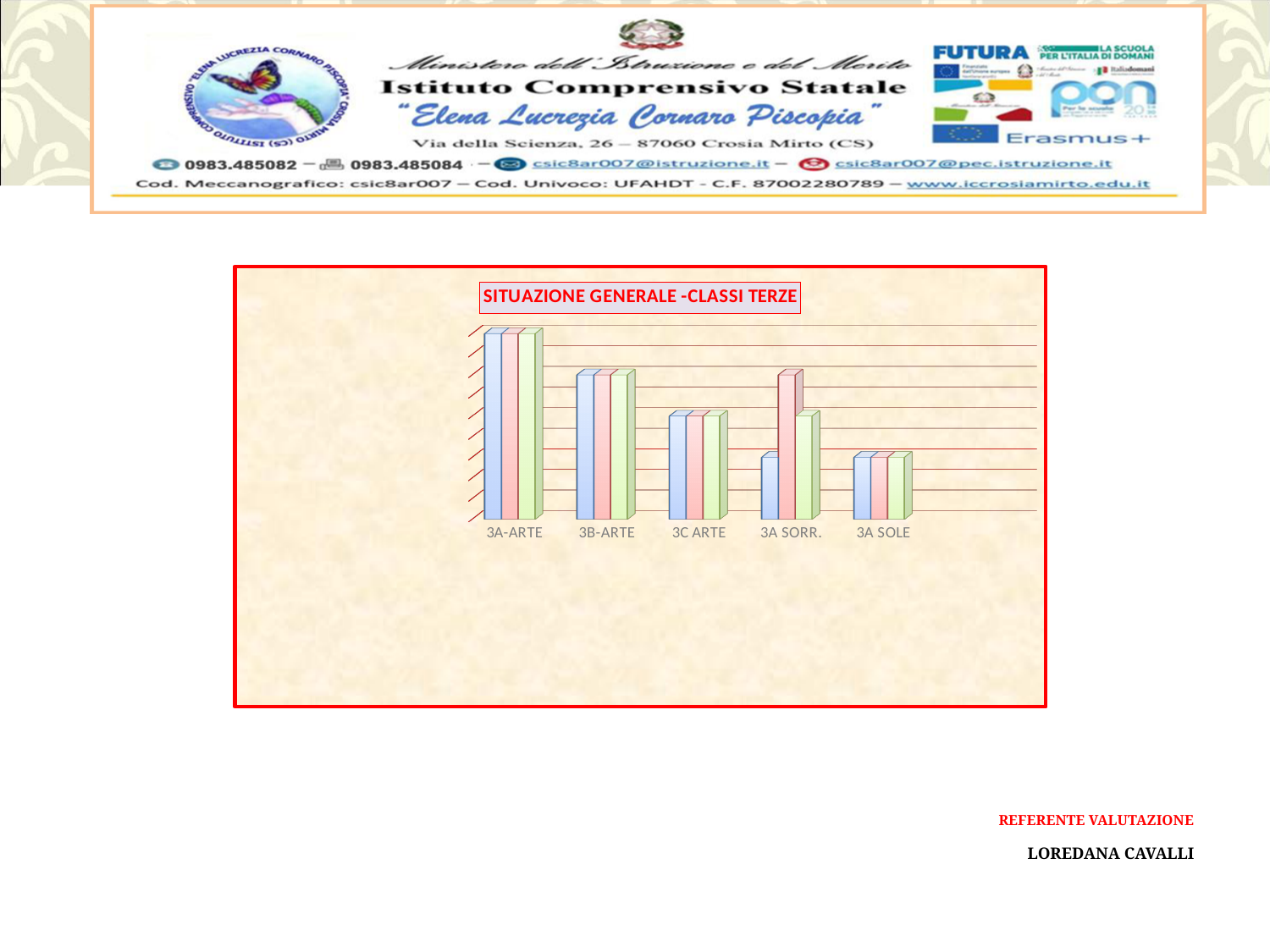
Which category has the shortest green bar? 3A SOLE Which category has the tallest pink bar? 3A-ARTE Which category has the tallest bars in the chart? 3A-ARTE Which category has taller bars, 3C ARTE or 3A SOLE? 3C ARTE What is the title of the chart? SITUAZIONE GENERALE -CLASSI TERZE How many bars are plotted for each category in the chart? 3 For 3A SORR., which bar is taller, the blue one or the pink one? The pink one Which category has the shortest pink bar? 3A SOLE What kind of chart is shown on the slide? Bar chart How many categories are shown on the x axis of the chart? 5 What is the label of the first category on the left of the x axis? 3A-ARTE Which category has taller bars, 3A-ARTE or 3B-ARTE? 3A-ARTE